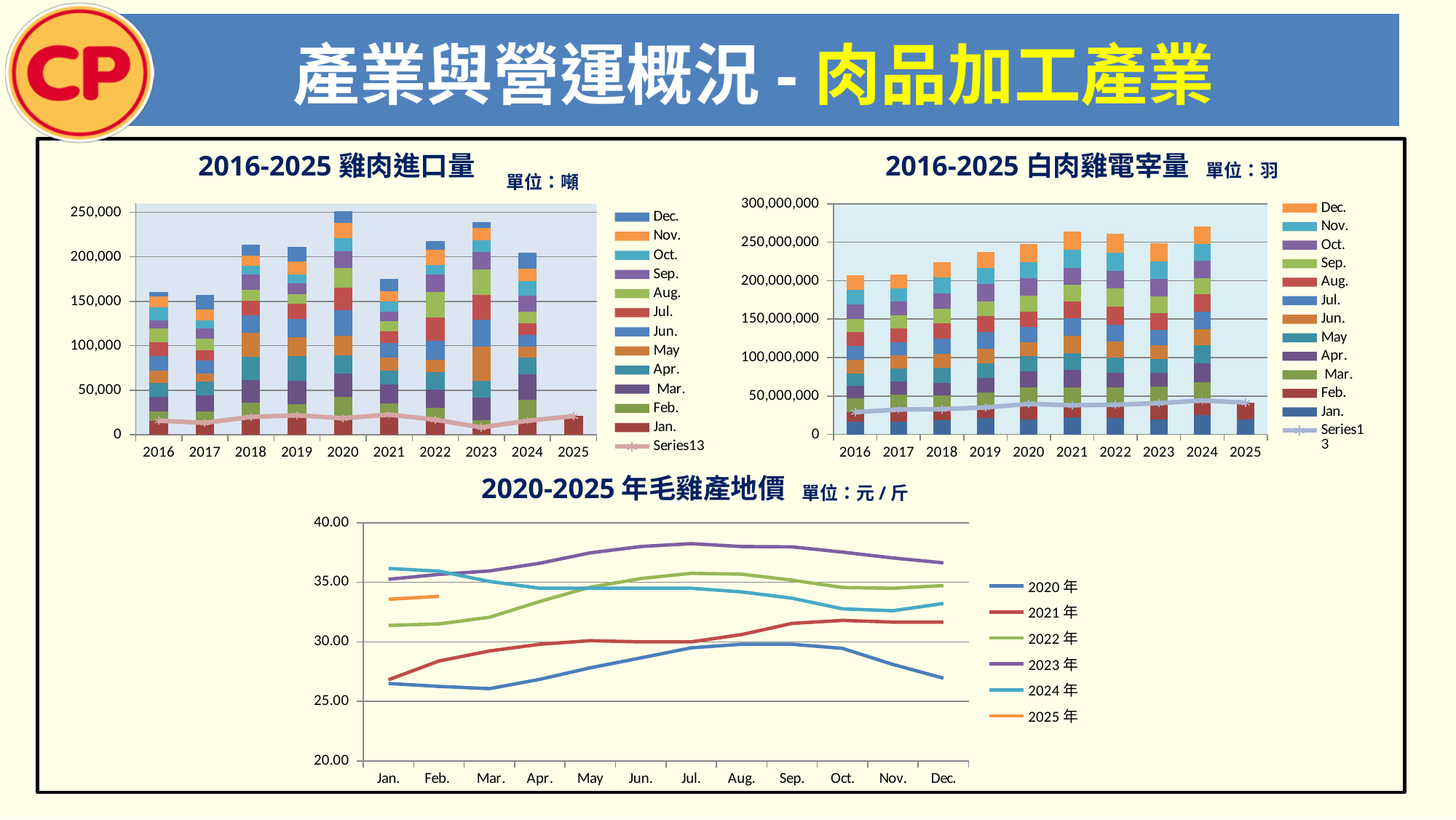
What type of chart is the "2016-2025 雞肉進口量" chart? stacked bar chart What unit is shown for the "2020-2025 年毛雞產地價" chart? 元 / 斤 In the "2016-2025 雞肉進口量" chart, is the total for 2021 greater or less than 200,000? less In the "2016-2025 白肉雞電宰量" chart, is the total for 2016 greater or less than 250,000,000? less In the "2020-2025 年毛雞產地價" chart, which year's line is highest in Jul.? 2023 年 In the "2020-2025 年毛雞產地價" chart, is the value for 2020 年 in Mar. greater or less than 30.00? less In the "2016-2025 白肉雞電宰量" chart, which year has the lowest total bar? 2025 How many series does the legend of the "2020-2025 年毛雞產地價" chart list? 6 How many years are shown on the x axis of the "2016-2025 白肉雞電宰量" chart? 10 In the "2016-2025 雞肉進口量" chart, which year has the highest total bar? 2020